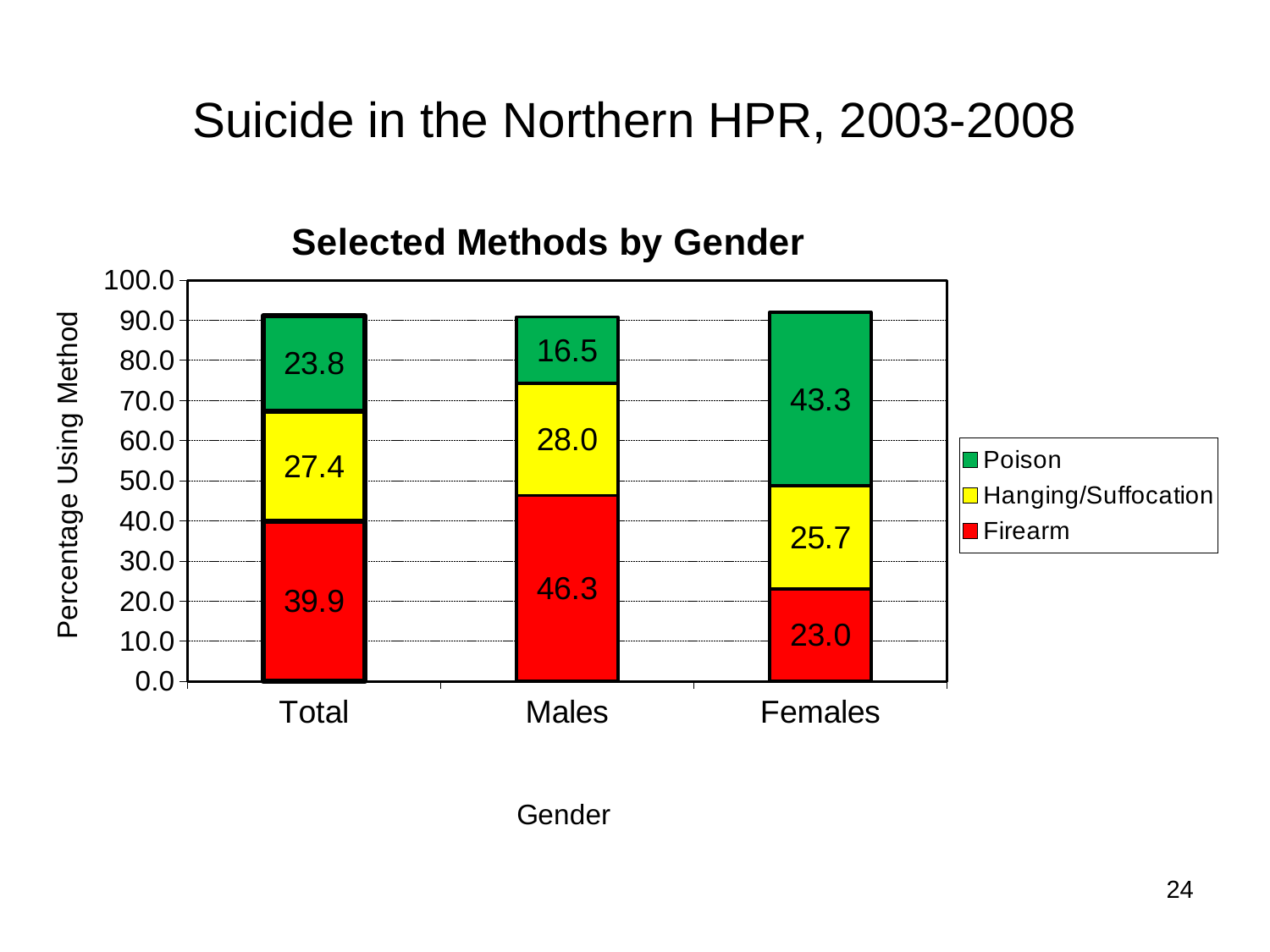
What is the total of the stacked bar for Males? 90.8 What is the Poison percentage for Females? 43.3 What is the title of the chart? Selected Methods by Gender How many series does the legend list? 3 What is the Firearm percentage for Males? 46.3 Which gender category has the highest Poison percentage? Females Is the Poison percentage larger for Males or for Females? Females How many gender categories are shown on the x axis? 3 What is the difference between the Firearm percentage for Males and for Females? 23.3 What is the Hanging/Suffocation percentage for Total? 27.4 What kind of chart is shown? Stacked bar chart Which gender category has the lowest Firearm percentage? Females